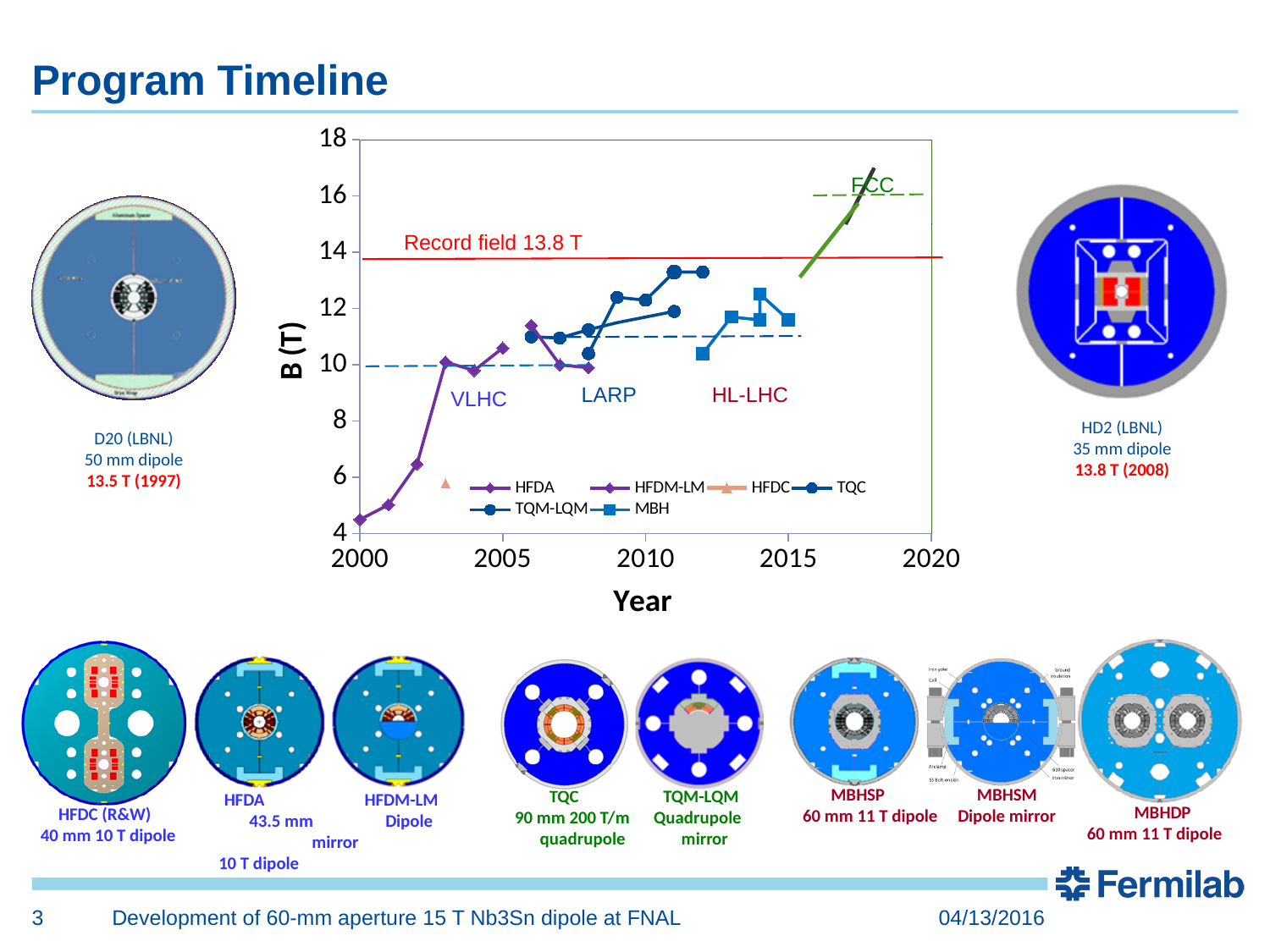
Is the HFDA value in 2000 greater or less than 6? less Which is larger, the HFDA value in 2000 or the HFDA value in 2003? 2003 What record field value is annotated by the red horizontal line on the chart? 13.8 T Is the MBH value in 2012 greater or less than 12? less What is the label of the y axis of the chart? B (T) Is the HFDA value in 2003 greater or less than 8? greater Which legend series is drawn with triangle markers? HFDC In which year is the HFDA value lowest? 2000 How many series does the chart legend list? 6 What kind of chart is shown on the slide? line chart Do the HFDA values rise or fall from 2000 to 2003? rise